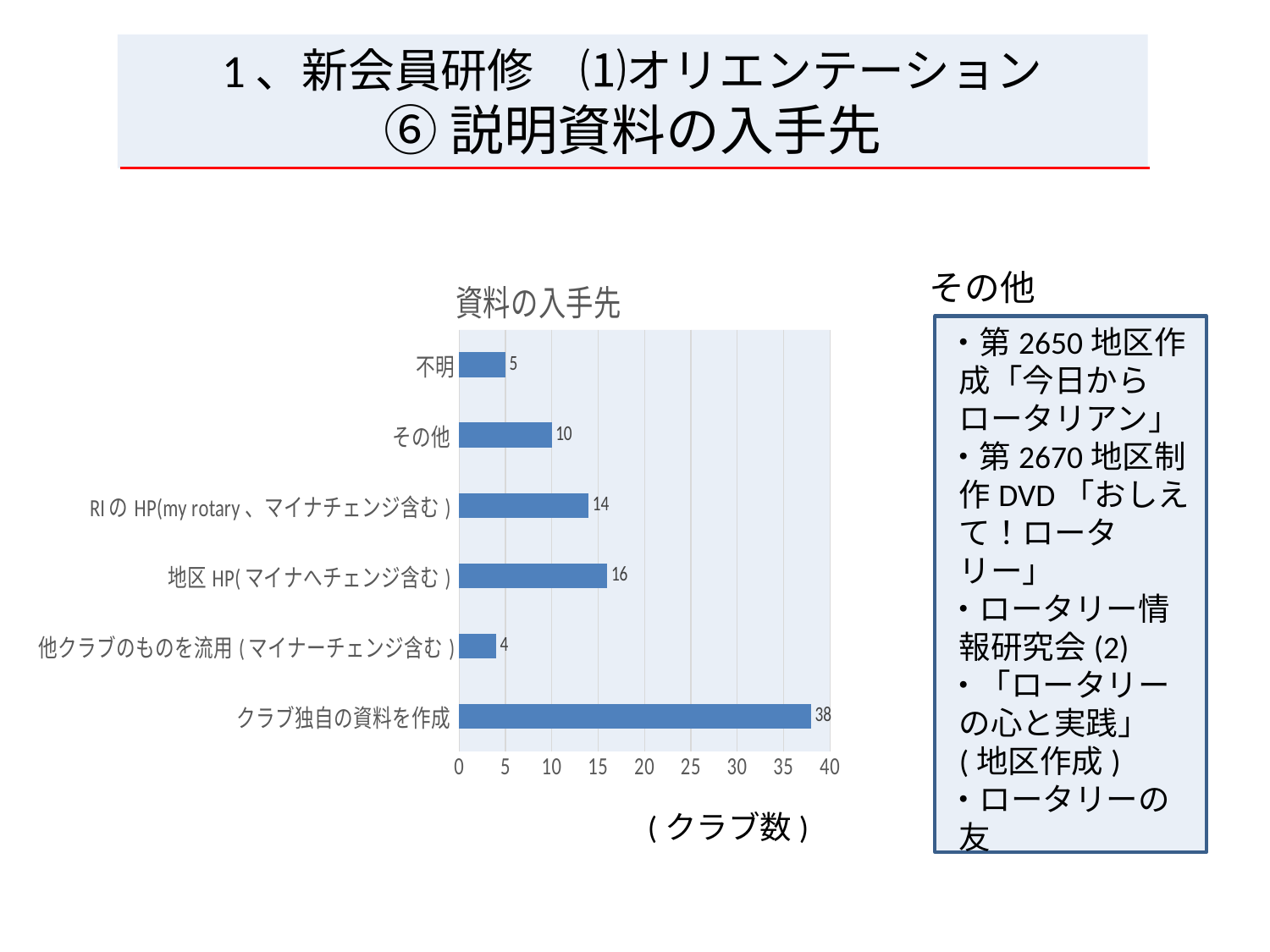
Is the value for クラブ独自の資料を作成 greater or less than 35? greater What is the value for RIのHP(my rotary、マイナチェンジ含む)? 14 What kind of chart is shown? bar chart Which category has the lowest value? 他クラブのものを流用(マイナーチェンジ含む) What is the value for クラブ独自の資料を作成? 38 What is the title of the chart? 資料の入手先 What is the difference between クラブ独自の資料を作成 and 地区HP(マイナへチェンジ含む)? 22 Which is larger, その他 or 他クラブのものを流用(マイナーチェンジ含む)? その他 What is the value for 地区HP(マイナへチェンジ含む)? 16 Which category has the highest value? クラブ独自の資料を作成 What is the value for 不明? 5 How many categories are shown in the chart? 6